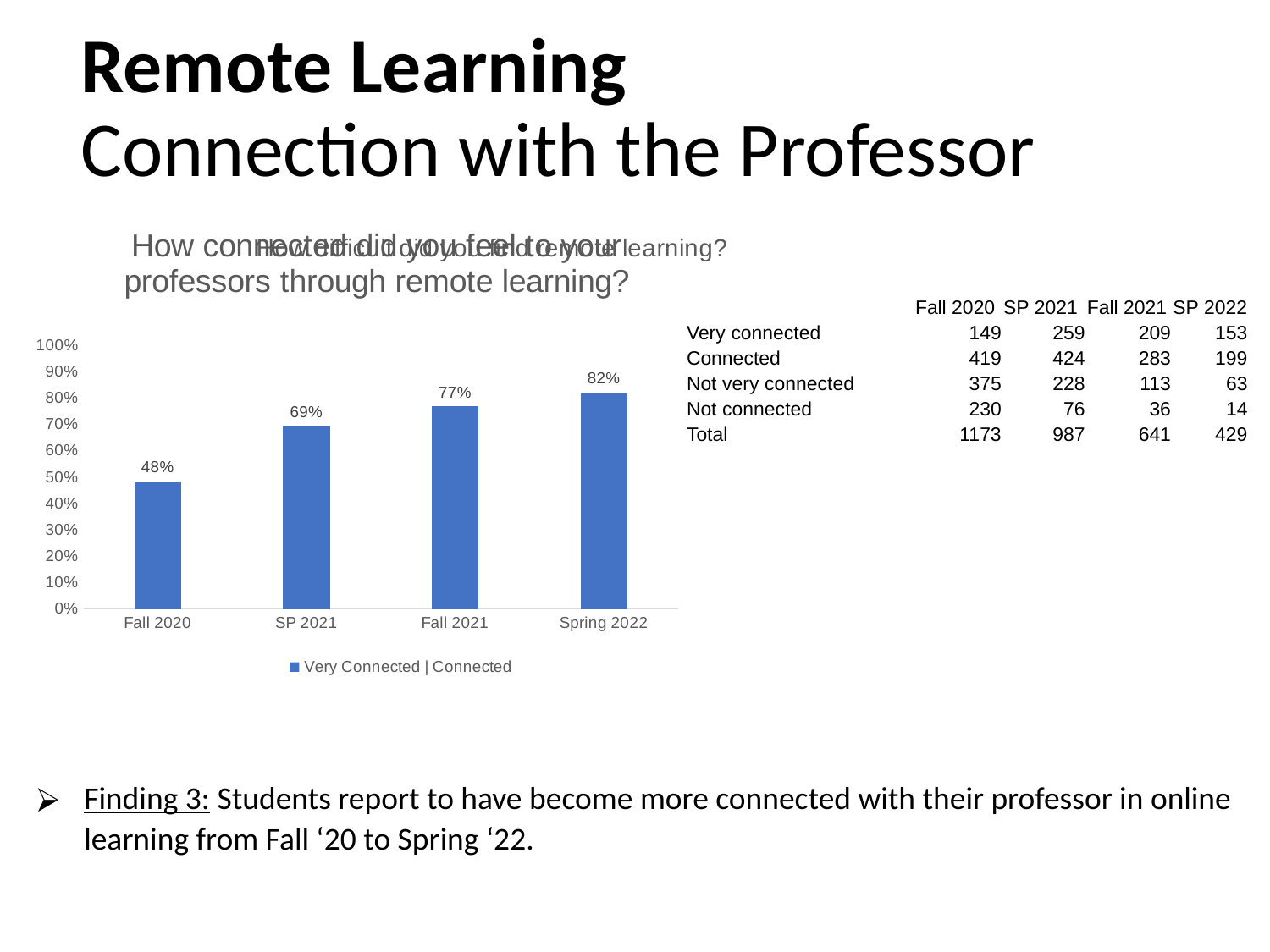
Which category has the highest value in the bar chart? Spring 2022 What is the value for SP 2021 in the bar chart? 69% How many categories are shown on the x axis of the bar chart? 4 What is the difference between the Spring 2022 value and the Fall 2020 value in the bar chart? 34% Which is larger in the bar chart, the value for SP 2021 or the value for Fall 2021? Fall 2021 What is the value for Fall 2021 in the bar chart? 77% Is the value for Fall 2020 in the bar chart greater or less than 50%? less What kind of chart is shown on the slide? bar chart Do the values in the bar chart rise or fall from Fall 2020 to Spring 2022? rise What is the value for Fall 2020 in the bar chart? 48% Which category has the lowest value in the bar chart? Fall 2020 What is the value for Spring 2022 in the bar chart? 82%